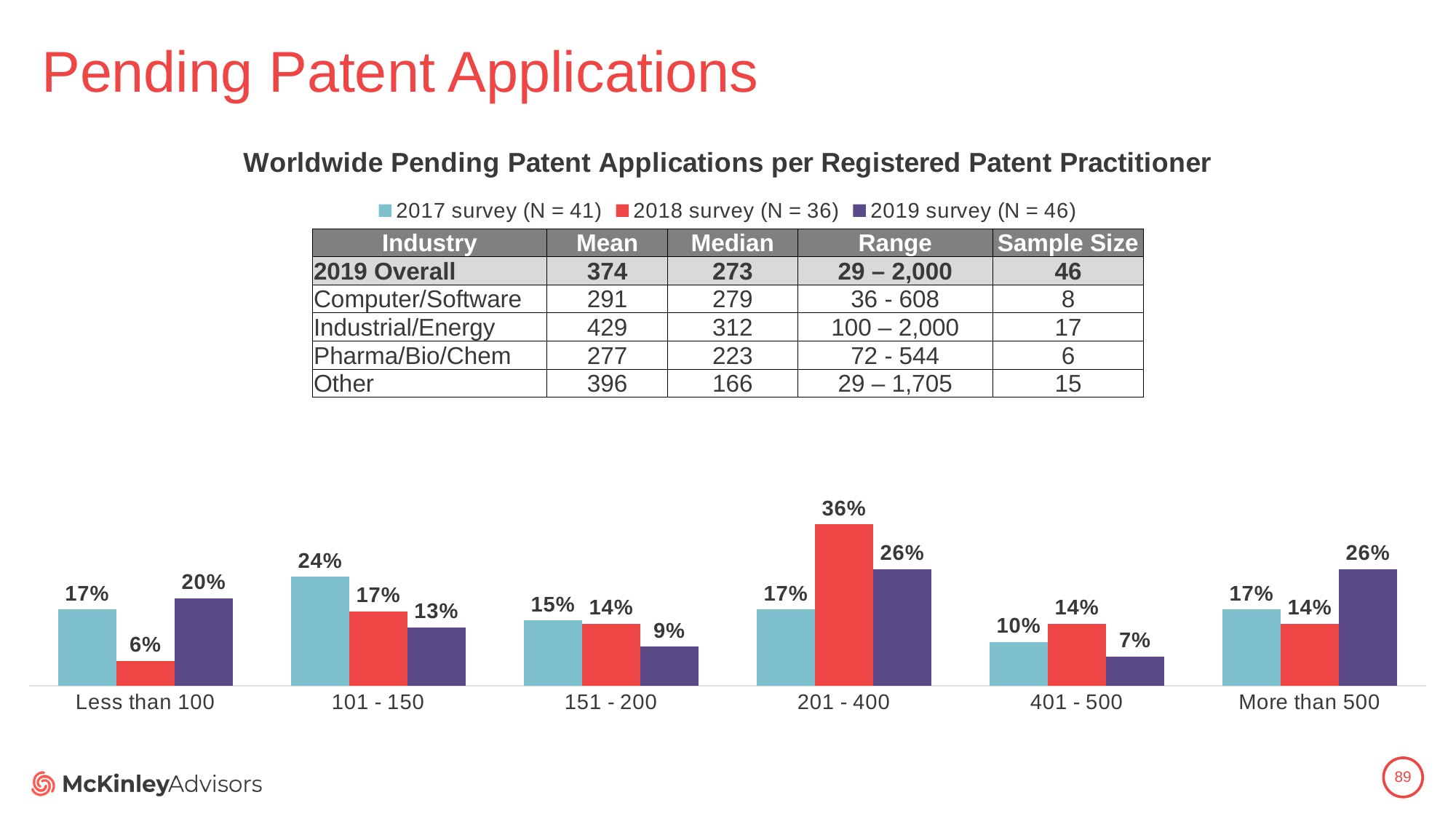
What is the sample size (N) for the 2019 survey according to the legend? 46 Which is larger in the 'More than 500' category: the 2017 survey value or the 2019 survey value? 2019 survey What is the value for the 2018 survey in the '201 - 400' category? 36% What is the value for the 2019 survey in the 'Less than 100' category? 20% How many series does the chart legend list? 3 How many categories are shown on the x axis of the chart? 6 What is the difference between the 2018 survey and 2019 survey values in the '201 - 400' category? 10% Which category has the lowest value for the 2019 survey? 401 - 500 What kind of chart is shown on the slide? Bar chart What is the title of the chart? Worldwide Pending Patent Applications per Registered Patent Practitioner What is the value for the 2017 survey in the '401 - 500' category? 10% Which category has the highest value for the 2018 survey? 201 - 400